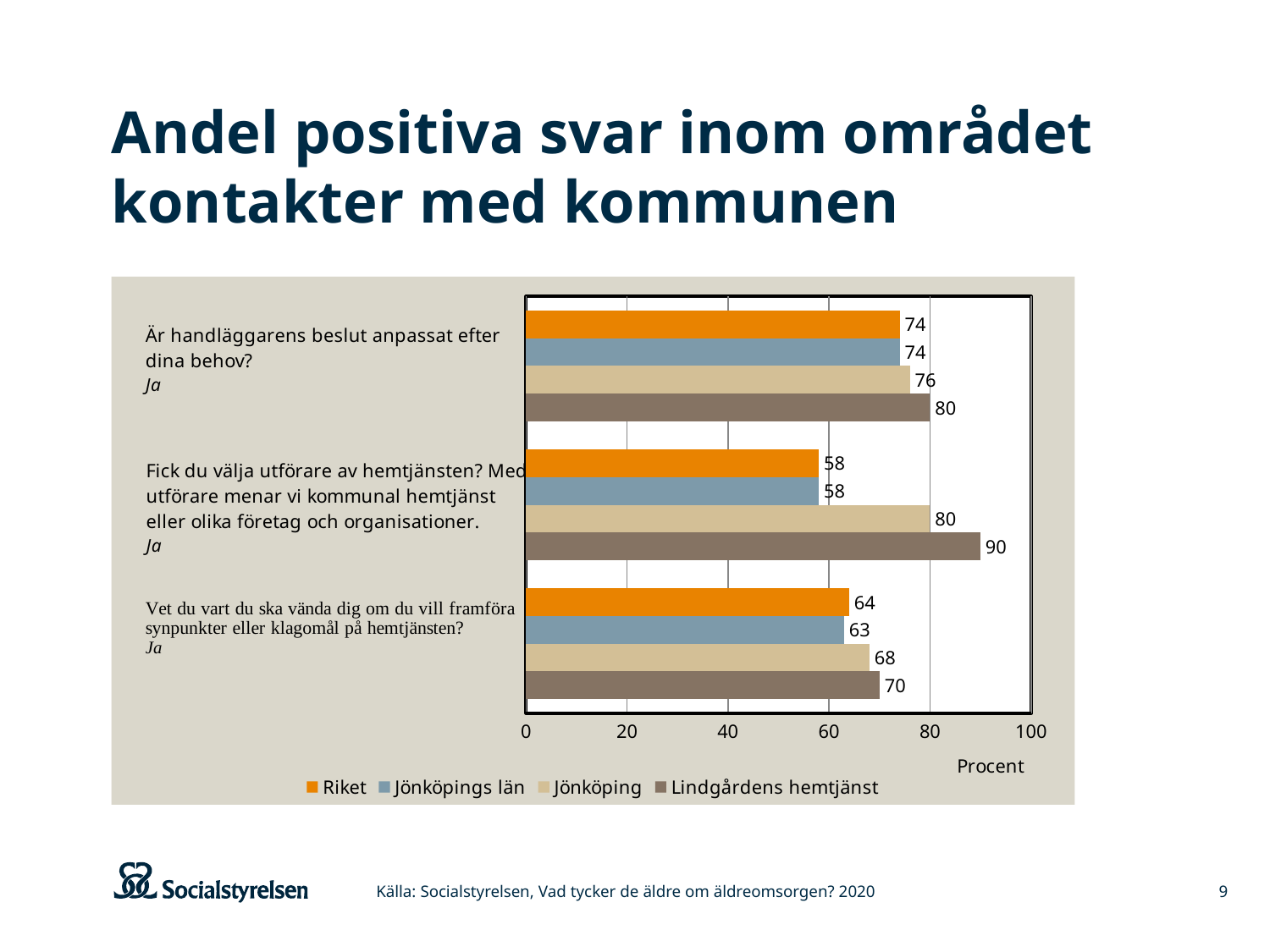
Is the value for Jönköpings län for the question "Fick du välja utförare av hemtjänsten?" greater or less than 60? less What unit label is shown under the x axis of the chart? Procent Which is larger for the question "Är handläggarens beslut anpassat efter dina behov?": Jönköping or Lindgårdens hemtjänst? Lindgårdens hemtjänst How many question categories are shown on the y axis of the chart? 3 What is the value for Lindgårdens hemtjänst for the question "Fick du välja utförare av hemtjänsten?"? 90 Which series has the lowest value for the question "Vet du vart du ska vända dig om du vill framföra synpunkter eller klagomål på hemtjänsten?"? Jönköpings län What is the value for Riket for the question "Är handläggarens beslut anpassat efter dina behov?"? 74 Which series has the highest value for the question "Fick du välja utförare av hemtjänsten?"? Lindgårdens hemtjänst What kind of chart is shown on the slide? bar chart How many series does the legend list? 4 What is the value for Jönköping for the question "Vet du vart du ska vända dig om du vill framföra synpunkter eller klagomål på hemtjänsten?"? 68 What is the difference between Lindgårdens hemtjänst and Riket for the question "Fick du välja utförare av hemtjänsten?"? 32